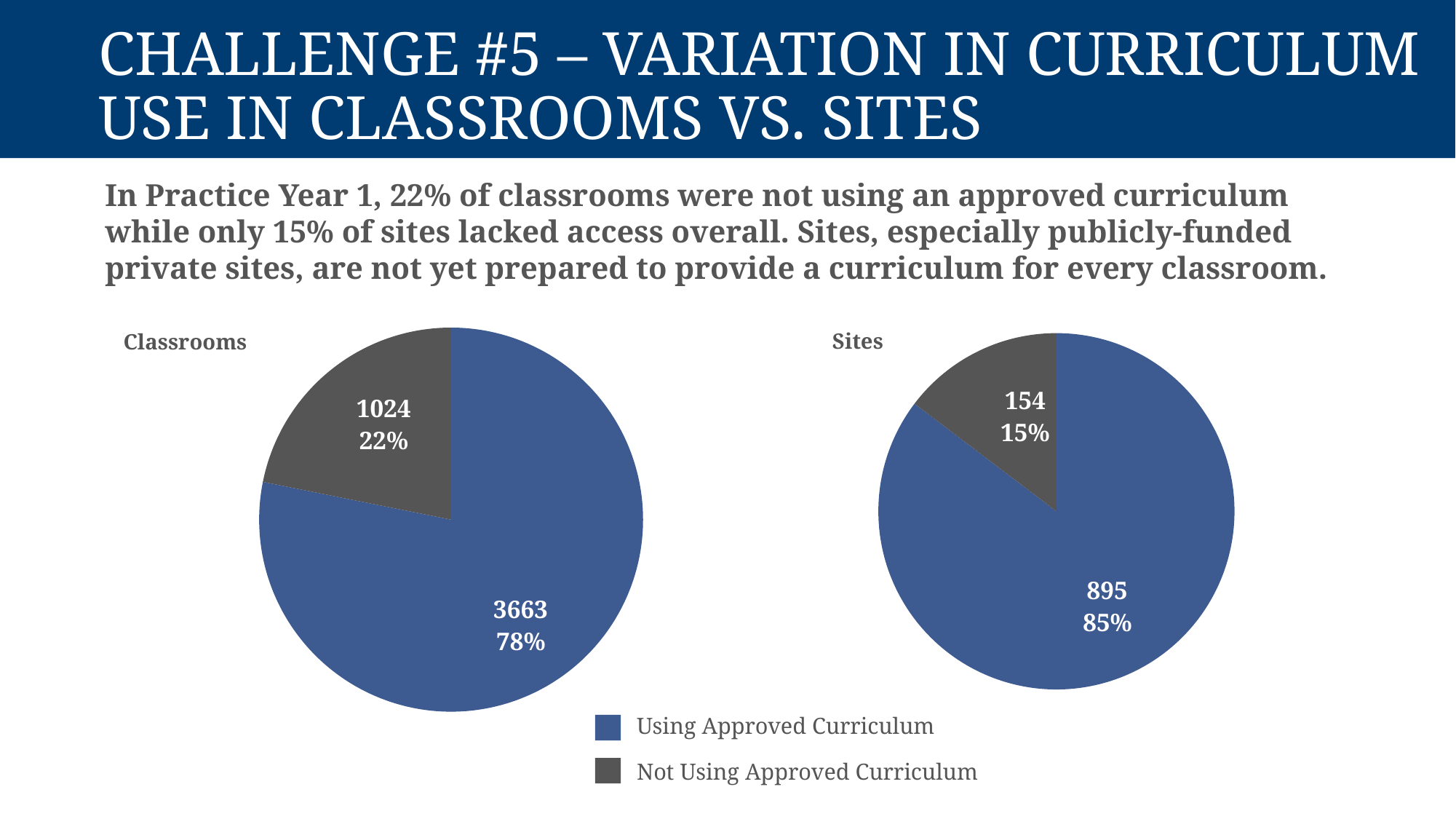
In the Sites pie chart, how many sites are not using an approved curriculum? 154 How many entries does the shared legend list? 2 What colour represents Not Using Approved Curriculum in the pie charts? Dark grey In the Classrooms pie chart, what is the difference between the number of classrooms using and not using an approved curriculum? 2639 What type of chart is used for the Classrooms data? Pie chart In the Classrooms pie chart, how many classrooms are using an approved curriculum? 3663 In the Classrooms pie chart, which slice is larger: Using Approved Curriculum or Not Using Approved Curriculum? Using Approved Curriculum In the Classrooms pie chart, what percentage of classrooms are not using an approved curriculum? 22% In the Sites pie chart, which category has the smallest slice? Not Using Approved Curriculum In the Sites pie chart, what is the total number of sites shown across both slices? 1049 In the Sites pie chart, what share of sites are using an approved curriculum? 85% How many slices does the Sites pie chart have? 2